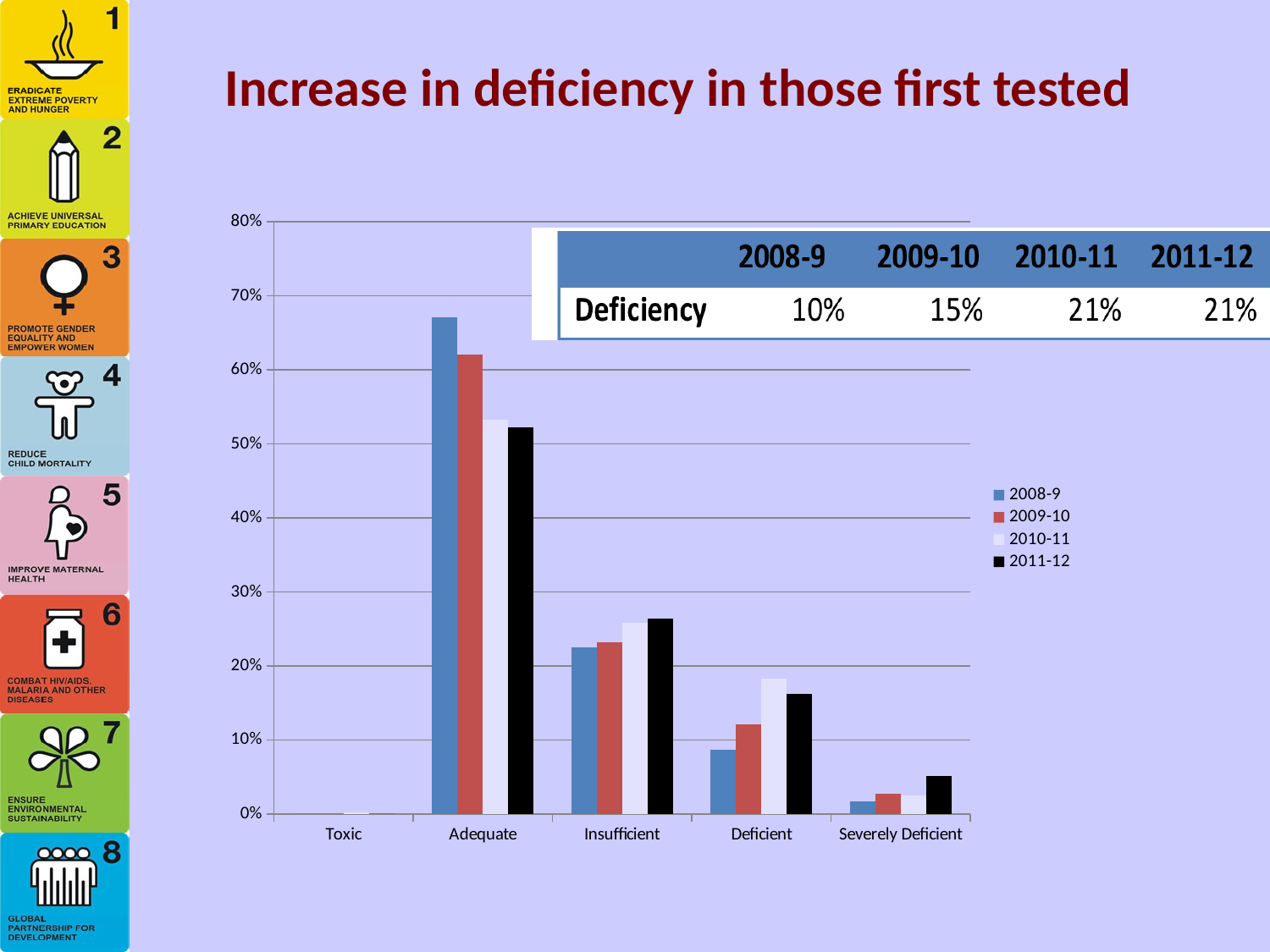
Is the 2011-12 value for Adequate greater or less than 60%? less Is the 2008-9 value for Deficient greater or less than 10%? less Which category has the lowest values across all series? Toxic Do the values for the Adequate category rise or fall from 2008-9 to 2011-12? fall What is the title of the slide's chart? Increase in deficiency in those first tested Is the 2011-12 value for Insufficient greater or less than 20%? greater How many series does the chart's legend list? 4 Which category has the highest value for the 2008-9 series? Adequate How many categories are shown on the x axis of the chart? 5 For the Adequate category, which is larger: the 2008-9 value or the 2011-12 value? 2008-9 What kind of chart is shown on the slide? bar chart